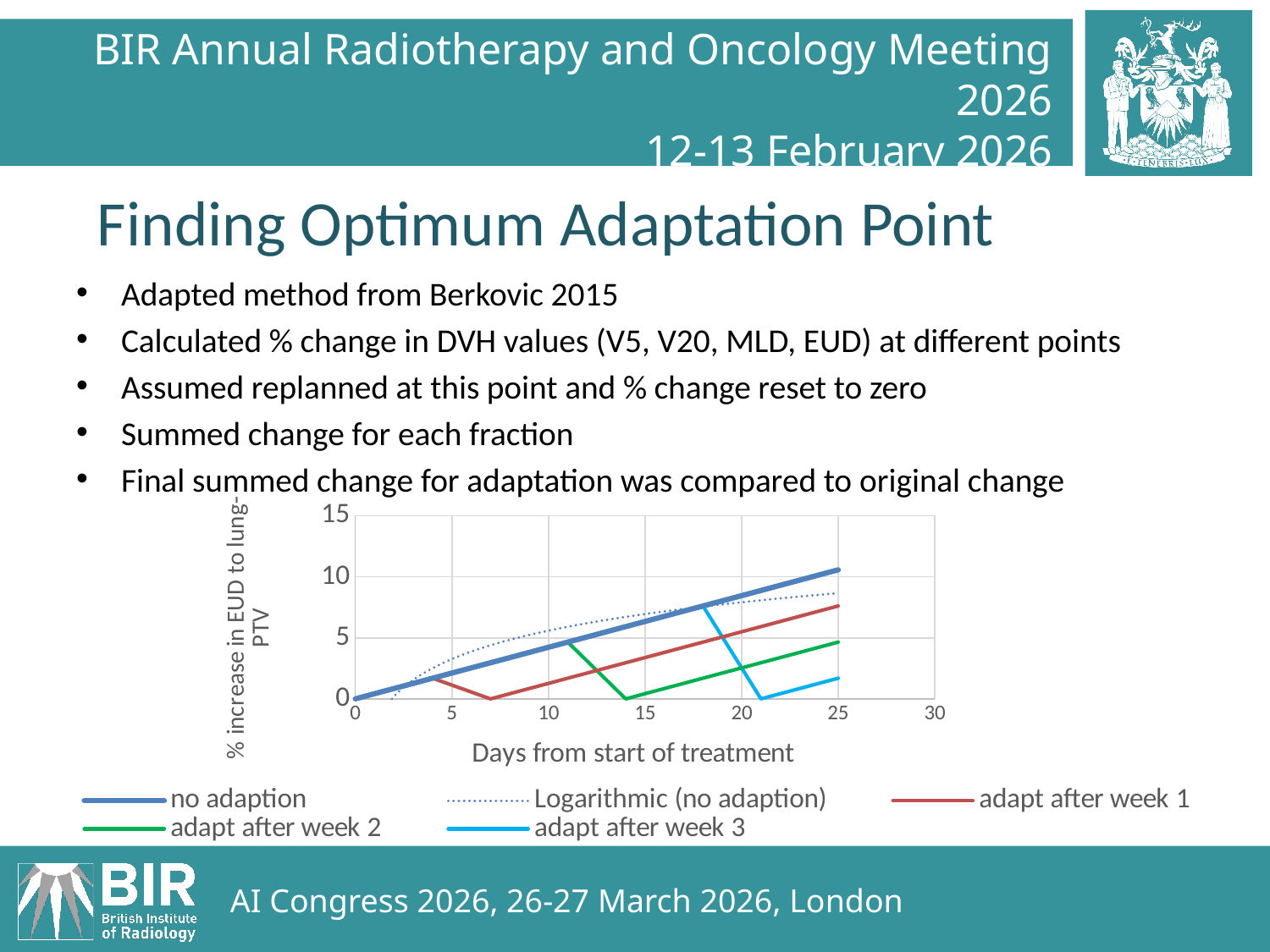
Which series has the lowest value at day 25? adapt after week 3 Which series has the highest value at day 25? no adaption At day 25, which is larger: the value for 'no adaption' or the value for 'adapt after week 3'? no adaption Is the value for 'no adaption' at day 25 greater or less than 5? greater What kind of chart is shown on the slide? line chart Is the value for 'no adaption' at day 10 greater or less than 5? less Is the value for 'adapt after week 1' at day 25 greater or less than 5? greater What is the title of the x axis of the chart? Days from start of treatment Does the 'no adaption' line rise or fall as days from start of treatment increase? rise How many series does the chart legend list? 5 What is the title of the y axis of the chart? % increase in EUD to lung-PTV